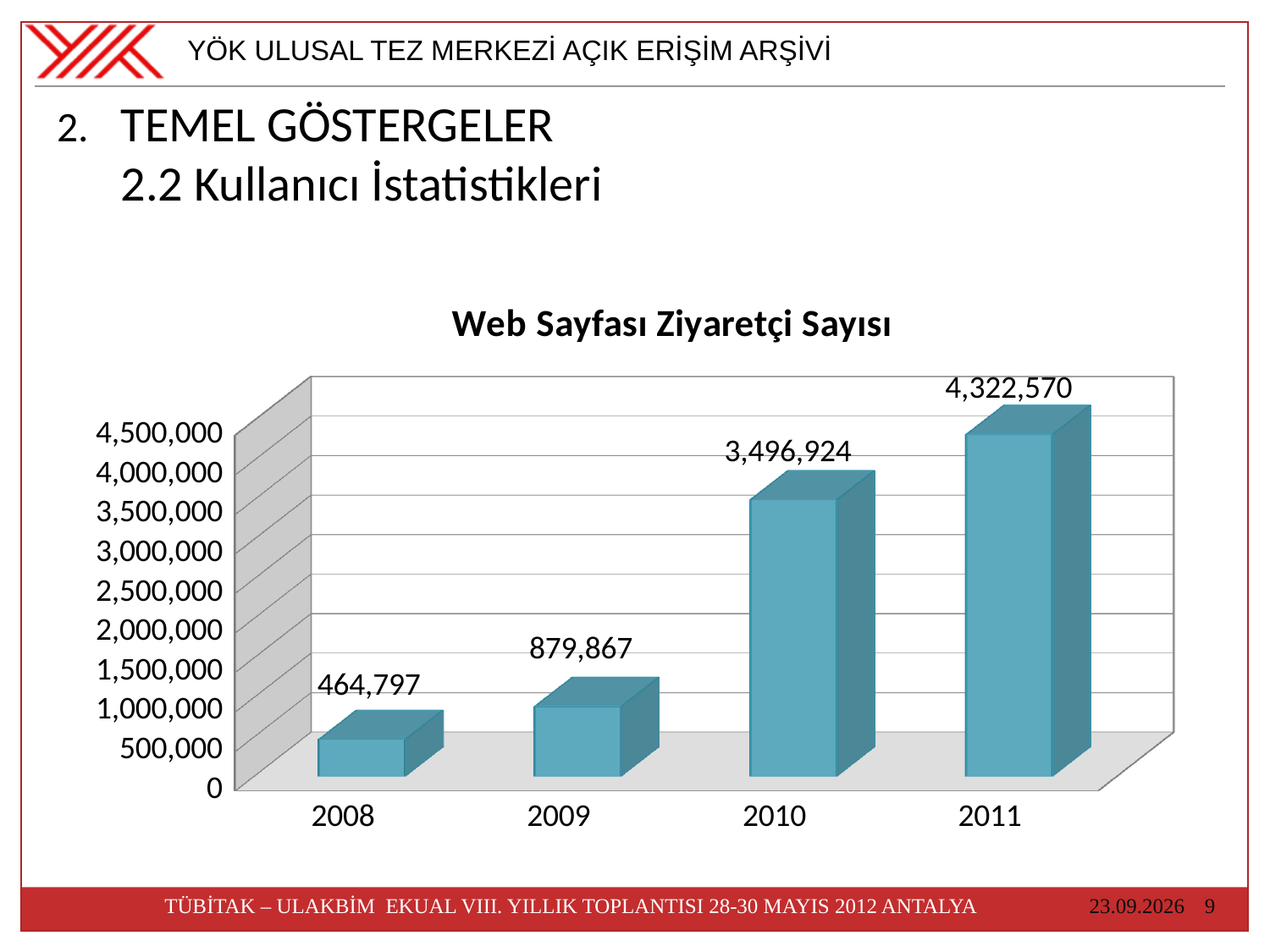
What is the value for 2011 in the Web Sayfası Ziyaretçi Sayısı chart? 4,322,570 Which year has the highest number of web page visitors? 2011 What is the difference between the values for 2011 and 2010? 825,646 What kind of chart is shown on the slide? Bar chart Which is larger, the value for 2009 or the value for 2010? 2010 How many years are shown on the x axis of the chart? 4 What is the difference between the values for 2009 and 2008? 415,070 Do the values rise or fall from 2008 to 2011? Rise What is the value for 2010 in the Web Sayfası Ziyaretçi Sayısı chart? 3,496,924 What is the value for 2009 in the Web Sayfası Ziyaretçi Sayısı chart? 879,867 What is the value for 2008 in the Web Sayfası Ziyaretçi Sayısı chart? 464,797 Which year has the lowest number of web page visitors? 2008